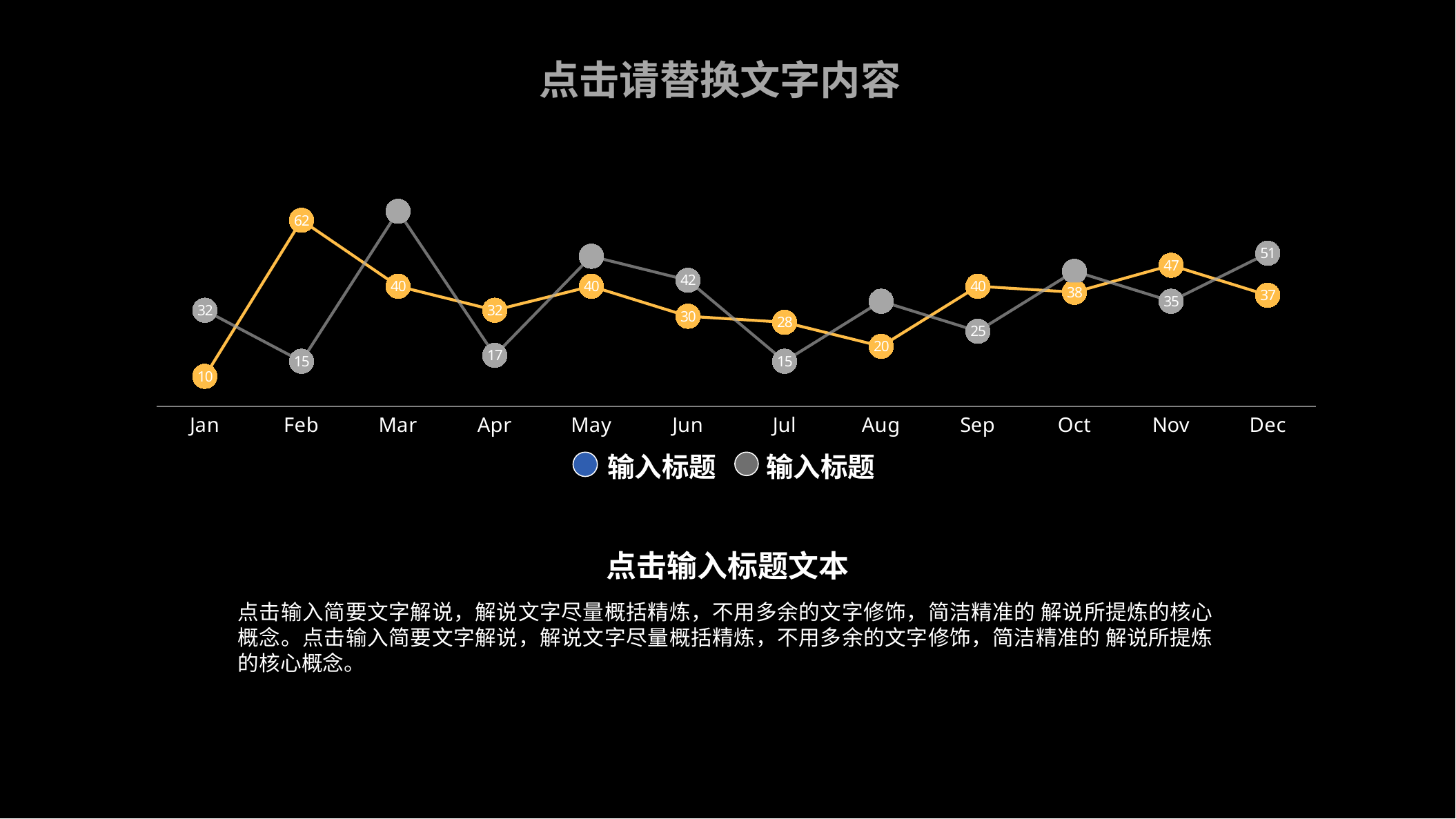
How many months are shown on the x axis? 12 In which month does the orange series have its lowest value? Jan What is the difference between the orange series value in Feb and its value in Jan? 52 How many series does the legend list? 2 What is the value of the grey series in Dec? 51 What is the value of the orange series in Aug? 20 What kind of chart is shown on the slide? line chart What is the value of the grey series in Sep? 25 Which series has the larger value in Jun, orange or grey? grey In which month does the orange series reach its highest value? Feb In which month does the grey series reach its highest point? Mar What is the value of the orange series in Feb? 62